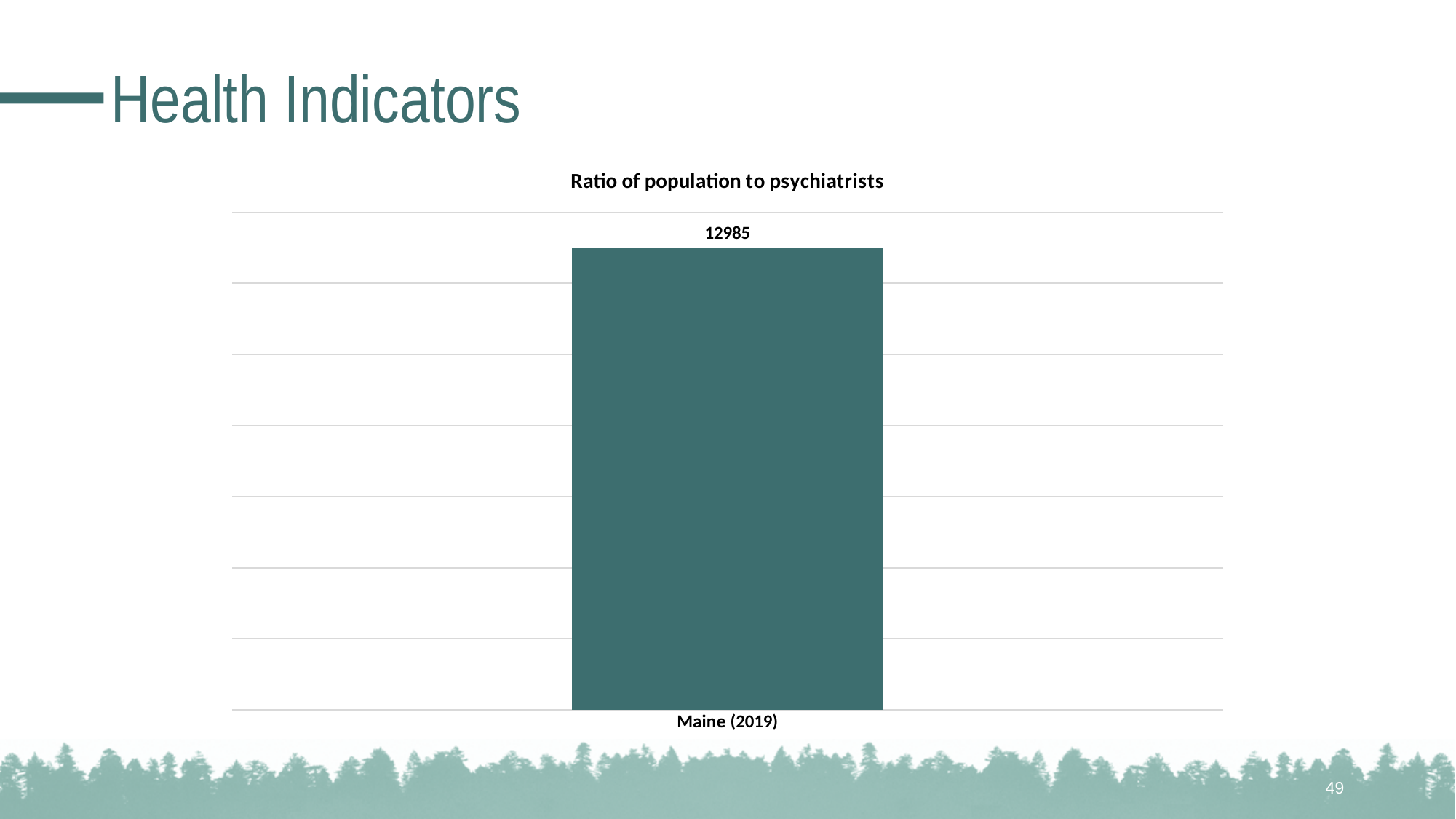
What is the label of the single category on the x axis? Maine (2019) What is the title of the chart? Ratio of population to psychiatrists Is the value for Maine (2019) greater or less than 10000? greater How many categories are plotted in the chart? 1 What is the value for Maine (2019) in the chart? 12985 What kind of chart is shown on the slide? bar chart